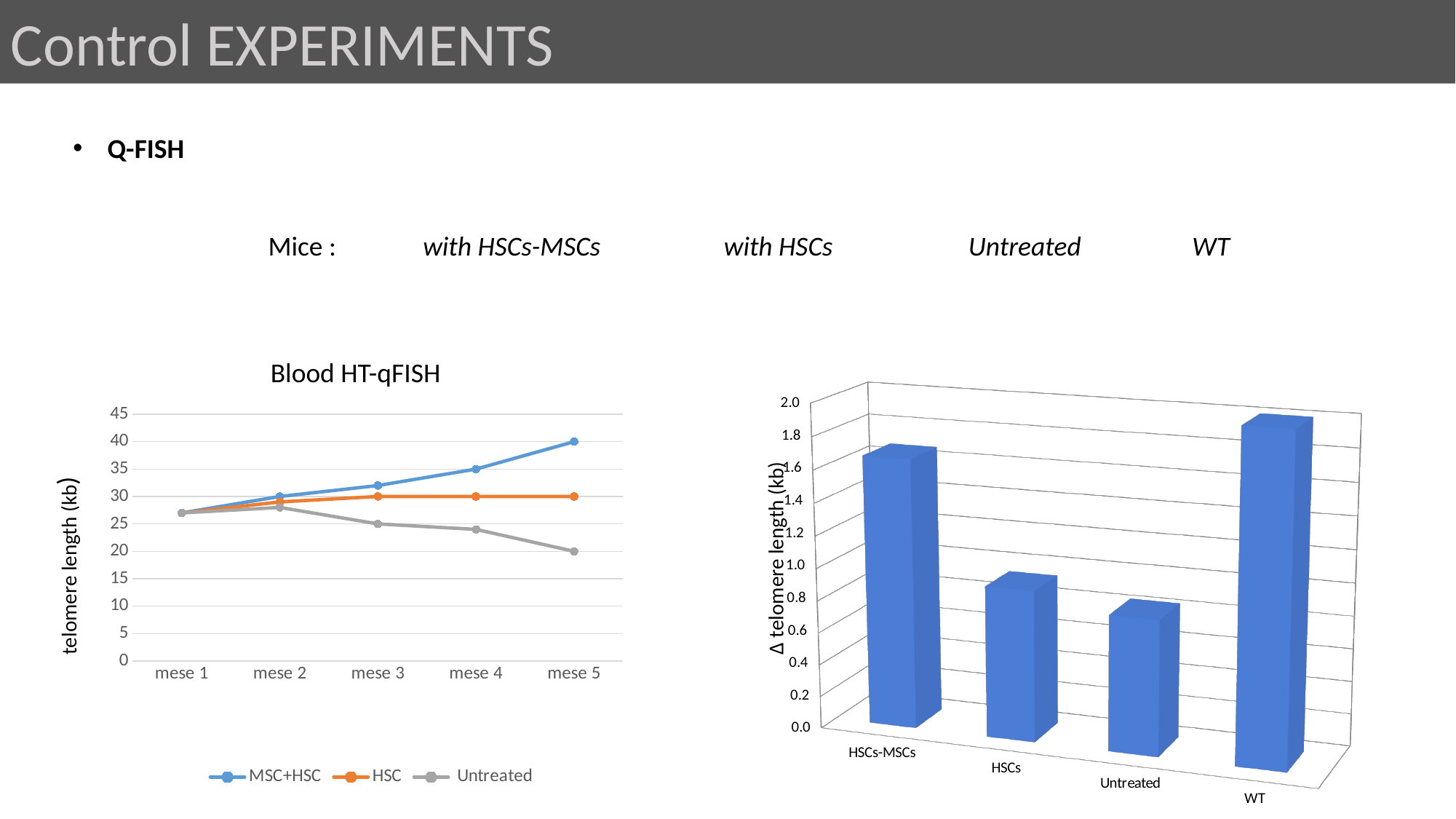
In the 'Blood HT-qFISH' chart, is the Untreated value at mese 5 greater or less than 25? less How many time points are shown on the x axis of the 'Blood HT-qFISH' chart? 5 In the 'Blood HT-qFISH' chart, does the Untreated series rise or fall from mese 2 to mese 5? fall How many series does the legend of the 'Blood HT-qFISH' chart list? 3 In the right-hand Δ telomere length chart, which category has the highest bar? WT In the right-hand Δ telomere length chart, which category has the lowest bar? Untreated In the 'Blood HT-qFISH' chart, does the MSC+HSC series rise or fall from mese 1 to mese 5? rise In the right-hand Δ telomere length chart, is the value for HSCs-MSCs greater or less than 1.0? greater In the 'Blood HT-qFISH' chart, is the MSC+HSC value at mese 5 greater or less than 35? greater What type of chart is the 'Blood HT-qFISH' chart on the left? line chart What type of chart is the chart on the right showing Δ telomere length (kb)? bar chart In the 'Blood HT-qFISH' chart, which series has the highest value at mese 5? MSC+HSC